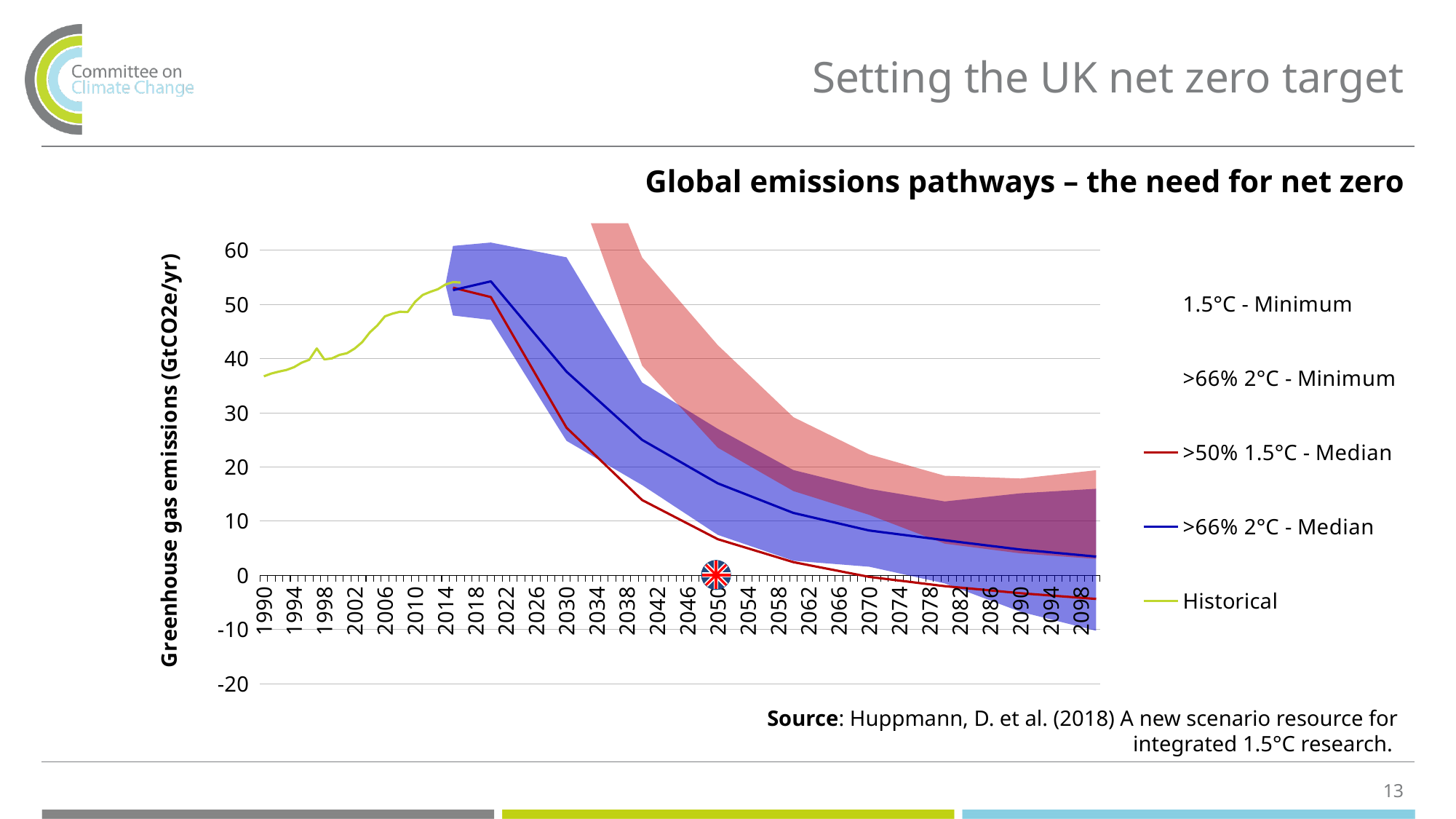
Does the Historical series rise or fall between 1990 and 2014? rise Is the Historical value in 1990 greater or less than 40? less In 2050, which is higher: the >50% 1.5°C - Median or the >66% 2°C - Median? >66% 2°C - Median Is the >50% 1.5°C - Median value in 2098 greater or less than 0? less Is the >66% 2°C - Median value in 2050 greater or less than 10? greater What is the label on the vertical axis of the chart? Greenhouse gas emissions (GtCO2e/yr) How many series does the legend list? 5 Does the >50% 1.5°C - Median series rise or fall between 2018 and 2098? fall What kind of chart is shown on the slide? combination area and line chart What is the title of the chart? Global emissions pathways – the need for net zero